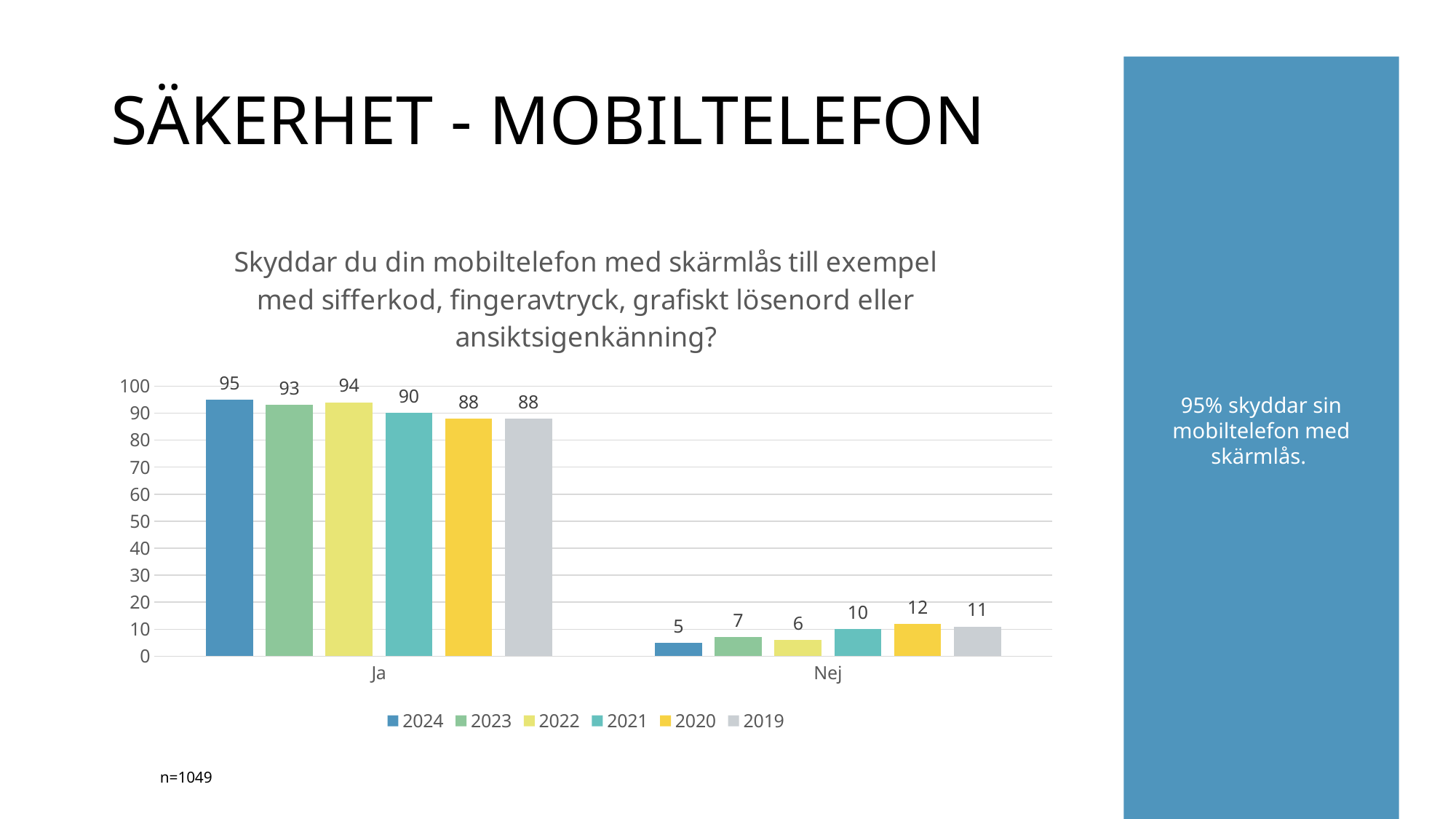
Which colour represents the 2020 series in the legend? yellow What is the difference between the 2024 and 2019 values in the Ja category? 7 What is the sample size noted on the slide? n=1049 Which is larger in the Nej category: the value for 2020 or the value for 2021? 2020 What kind of chart is shown on the slide? bar chart What is the value for 2021 in the Ja category? 90 How many series does the legend list? 6 Which year has the highest value in the Ja category? 2024 Which year has the lowest value in the Nej category? 2024 What is the value for 2019 in the Nej category? 11 What is the value for 2024 in the Ja category? 95 How many categories are shown on the x axis? 2